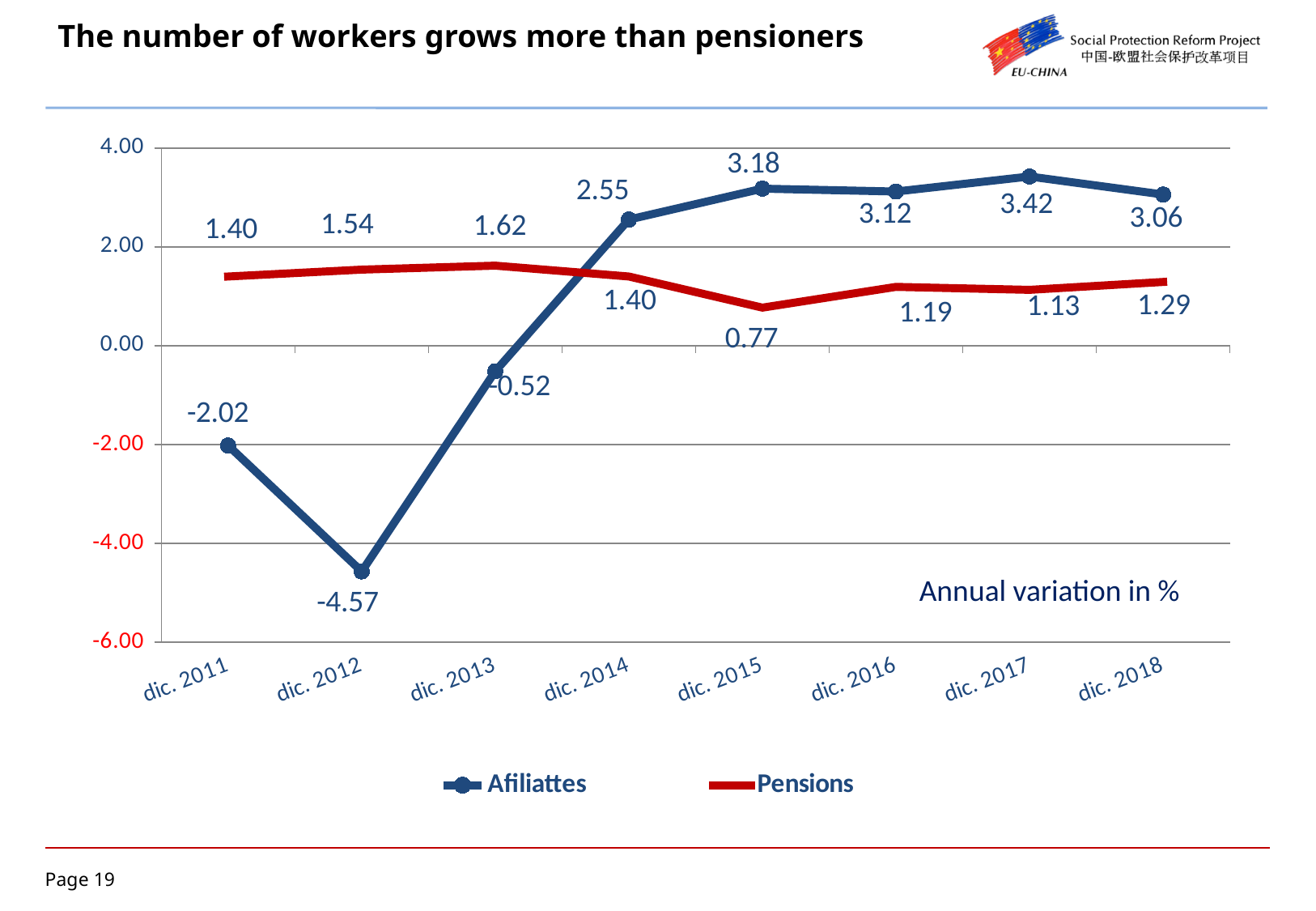
What is the difference between the Afiliattes and Pensions values at dic. 2018? 1.77 What is the value for Afiliattes at dic. 2012? -4.57 What is the value for Pensions at dic. 2015? 0.77 What is the value for Pensions at dic. 2013? 1.62 How many series does the legend list? 2 In which period does the Afiliattes series reach its lowest value? dic. 2012 What is the value for Afiliattes at dic. 2017? 3.42 What kind of chart is shown on the slide? Line chart Which series has the larger value at dic. 2011, Afiliattes or Pensions? Pensions Does the Afiliattes series rise or fall from dic. 2012 to dic. 2015? Rise In which period does the Pensions series reach its highest value? dic. 2013 How many time periods are shown on the x axis? 8